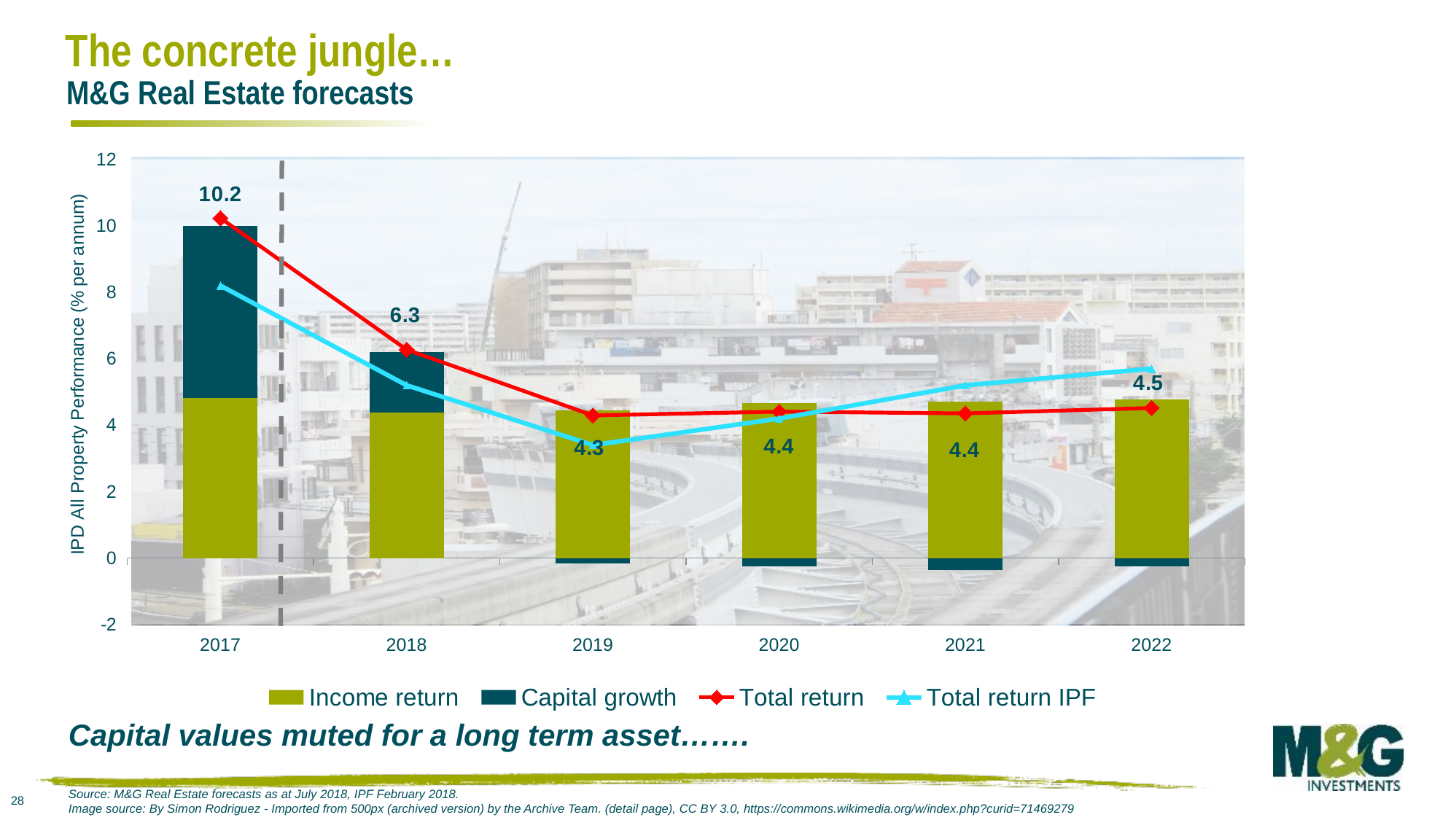
What is the Total return value for 2018? 6.3 What is the difference between the Total return in 2017 and in 2018? 3.9 Is the Income return bar for 2017 greater or less than 4? greater How many years are shown on the x axis? 6 Which year has the lowest labelled Total return? 2019 Does the Total return rise or fall from 2017 to 2019? fall How many series does the legend list? 4 Is the Total return IPF value for 2017 greater or less than 10? less What is the Total return value for 2022? 4.5 Which is larger, the Total return in 2018 or in 2022? 2018 Which year has the highest Total return? 2017 What is the Total return value for 2017? 10.2